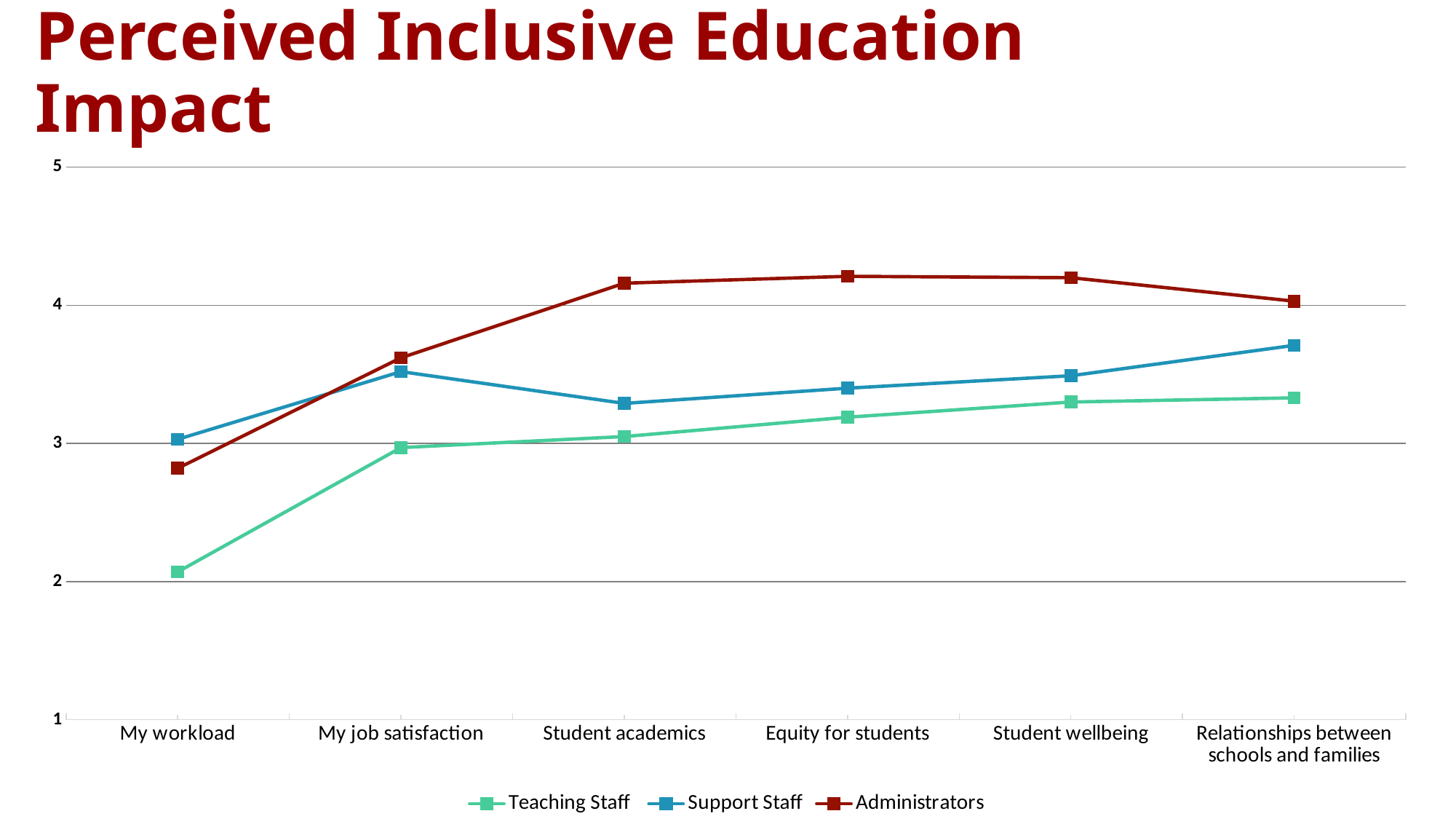
Is the Administrators value for My workload greater or less than 3? less Is the Support Staff value for Relationships between schools and families greater or less than 4? less Which series has the highest value for Student academics? Administrators Does the Teaching Staff line generally rise or fall from My workload to Relationships between schools and families? rise How many series does the legend list? 3 What is the title of the chart? Perceived Inclusive Education Impact For My workload, which is higher: Support Staff or Administrators? Support Staff What kind of chart is shown on the slide? line chart Is the Administrators value for Equity for students greater or less than 4? greater How many categories are shown along the x axis? 6 For which category is the Teaching Staff value lowest? My workload